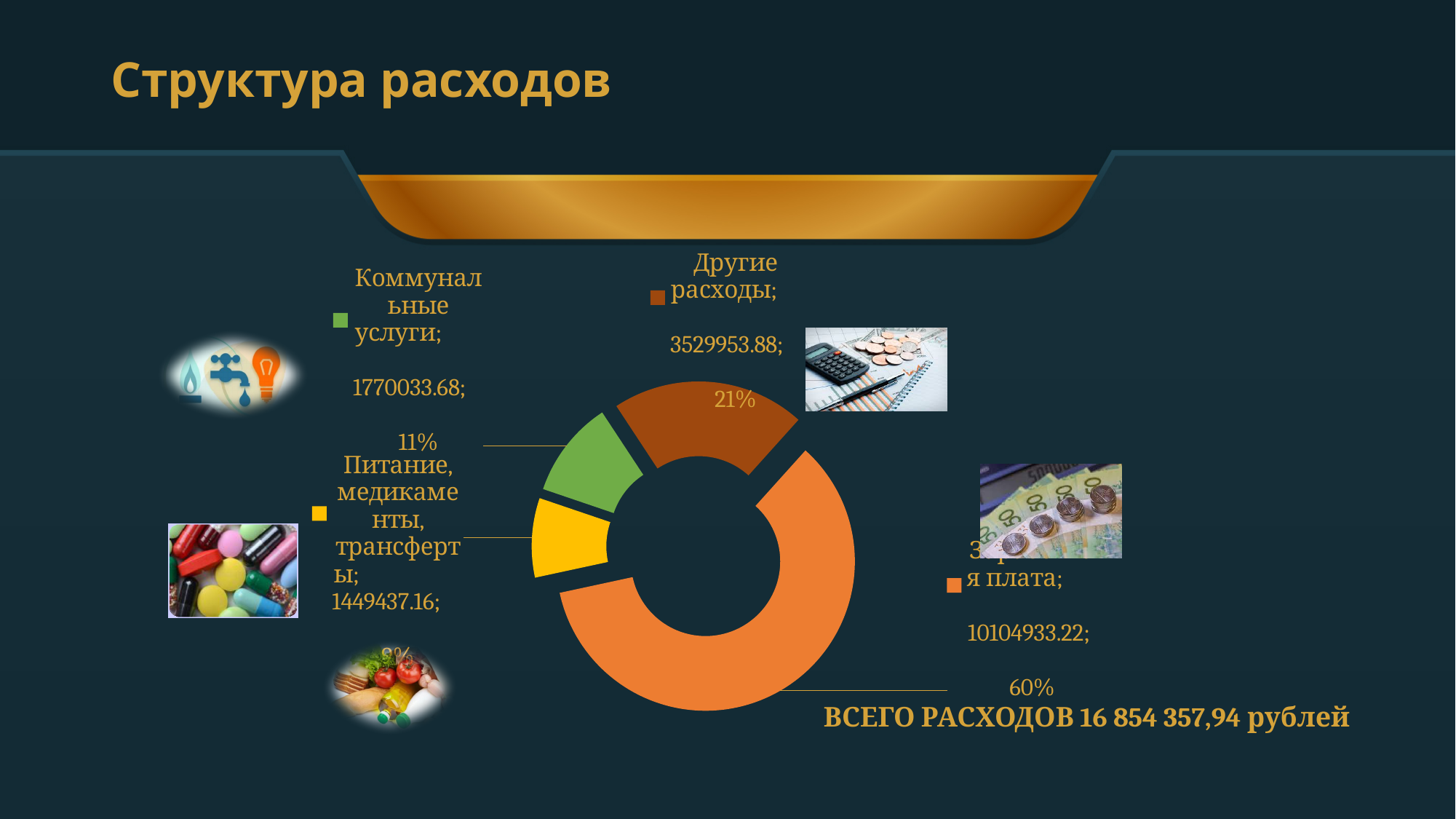
What share does the largest segment of the chart have? 60% What is the value of the segment that makes up 60% of the chart? 10104933.22 What is the difference between Другие расходы and Коммунальные услуги? 1759920.20 What is the value for Питание, медикаменты, трансферты? 1449437.16 Which is larger, Коммунальные услуги or Другие расходы? Другие расходы What share of the chart does Коммунальные услуги represent? 11% What share of the chart does Другие расходы represent? 21% What kind of chart is shown on the slide? doughnut (pie) chart What is the value for Коммунальные услуги? 1770033.68 How many categories does the chart show? 4 Which category has the smallest value in the chart? Питание, медикаменты, трансферты What is the value for Другие расходы? 3529953.88